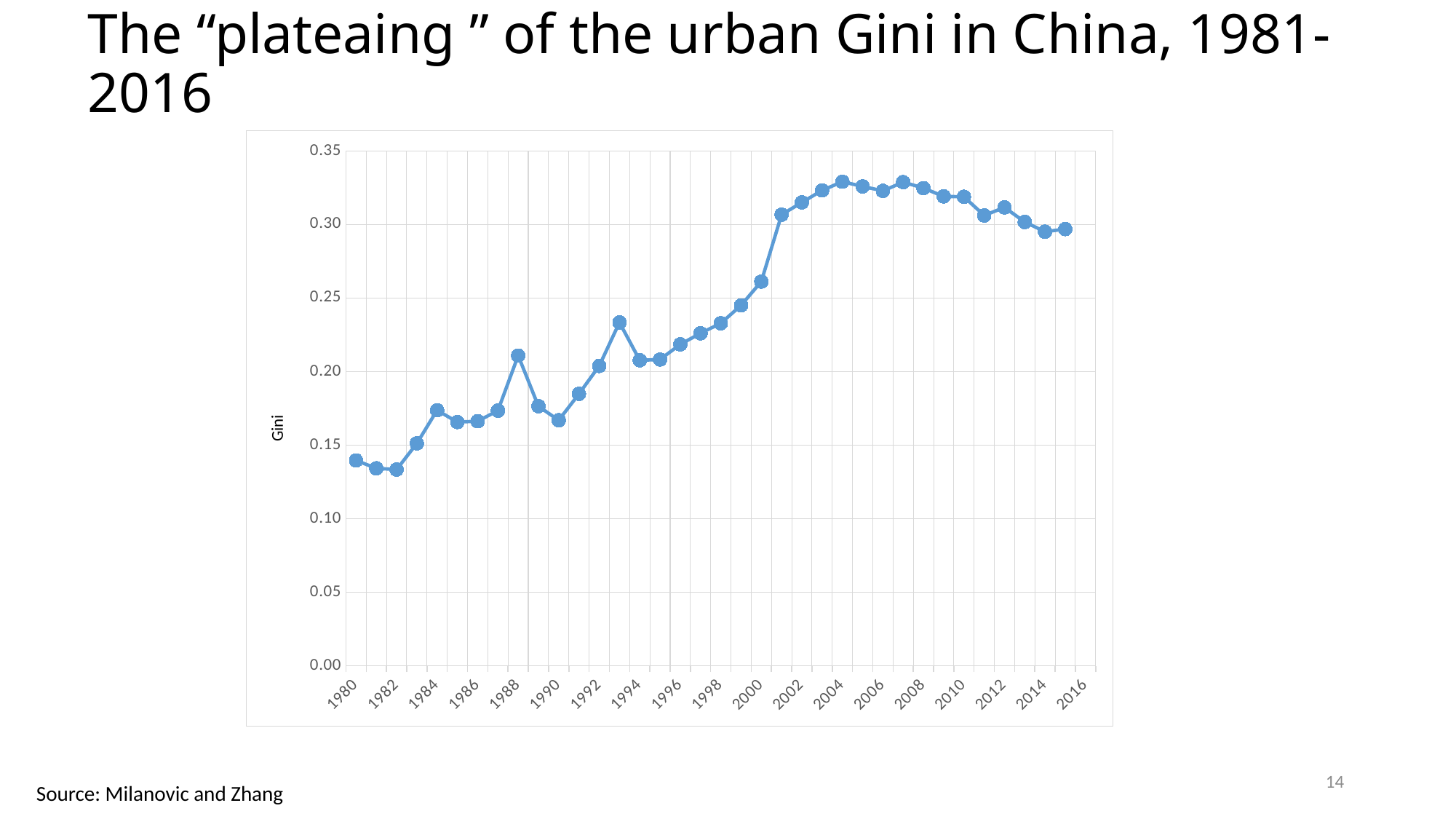
Is the value at the 1982 tick greater or less than 0.15? less Is the value at the 1990 tick greater or less than 0.20? less Is the value at the 2000 tick greater or less than 0.30? less Does the Gini value generally rise or fall between 1980 and 2004? Rise Does the Gini value generally rise or fall between 2008 and 2016? Fall What kind of chart is shown on the slide? Line chart Which is larger, the Gini value at the 2006 tick or at the 1996 tick? 2006 What source is cited for the chart? Milanovic and Zhang What is the label on the vertical axis of the chart? Gini